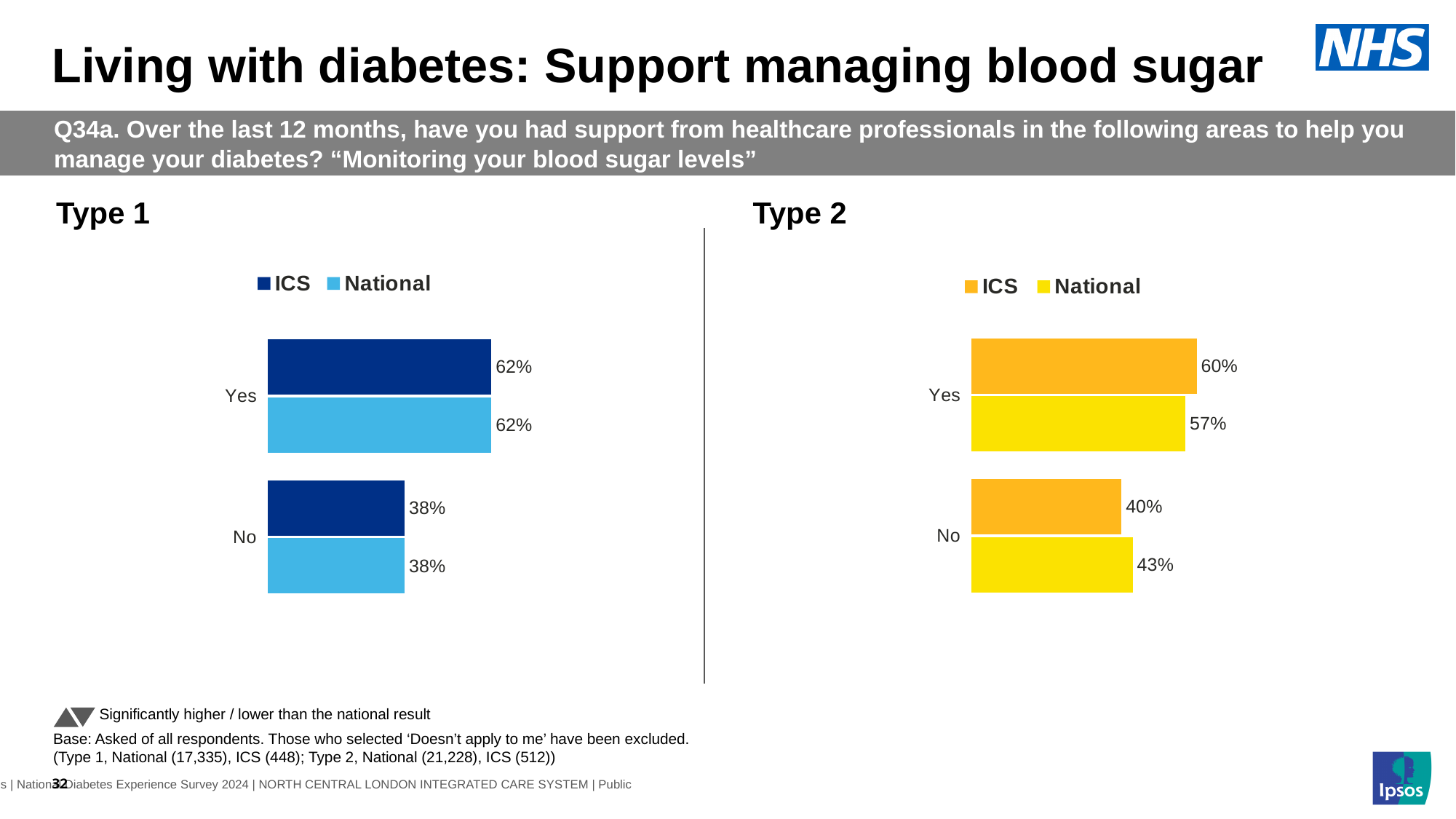
How many series does the legend of the Type 1 chart list? 2 In the Type 2 chart, what is the difference between the ICS and National values for Yes? 3 percentage points How many categories are shown in the Type 2 chart? 2 In the Type 2 chart, what is the ICS value for Yes? 60% In the Type 2 chart, what is the National value for No? 43% In the Type 2 chart, which series has the higher value for Yes? ICS In the Type 1 chart, what is the ICS value for Yes? 62% What kind of chart is the Type 1 chart? Bar chart What colour are the National bars in the Type 2 chart? Yellow In the Type 1 chart, what is the difference between the ICS and National values for Yes? 0 percentage points In the Type 2 chart, which is larger for No: ICS or National? National In the Type 1 chart, what is the National value for No? 38%